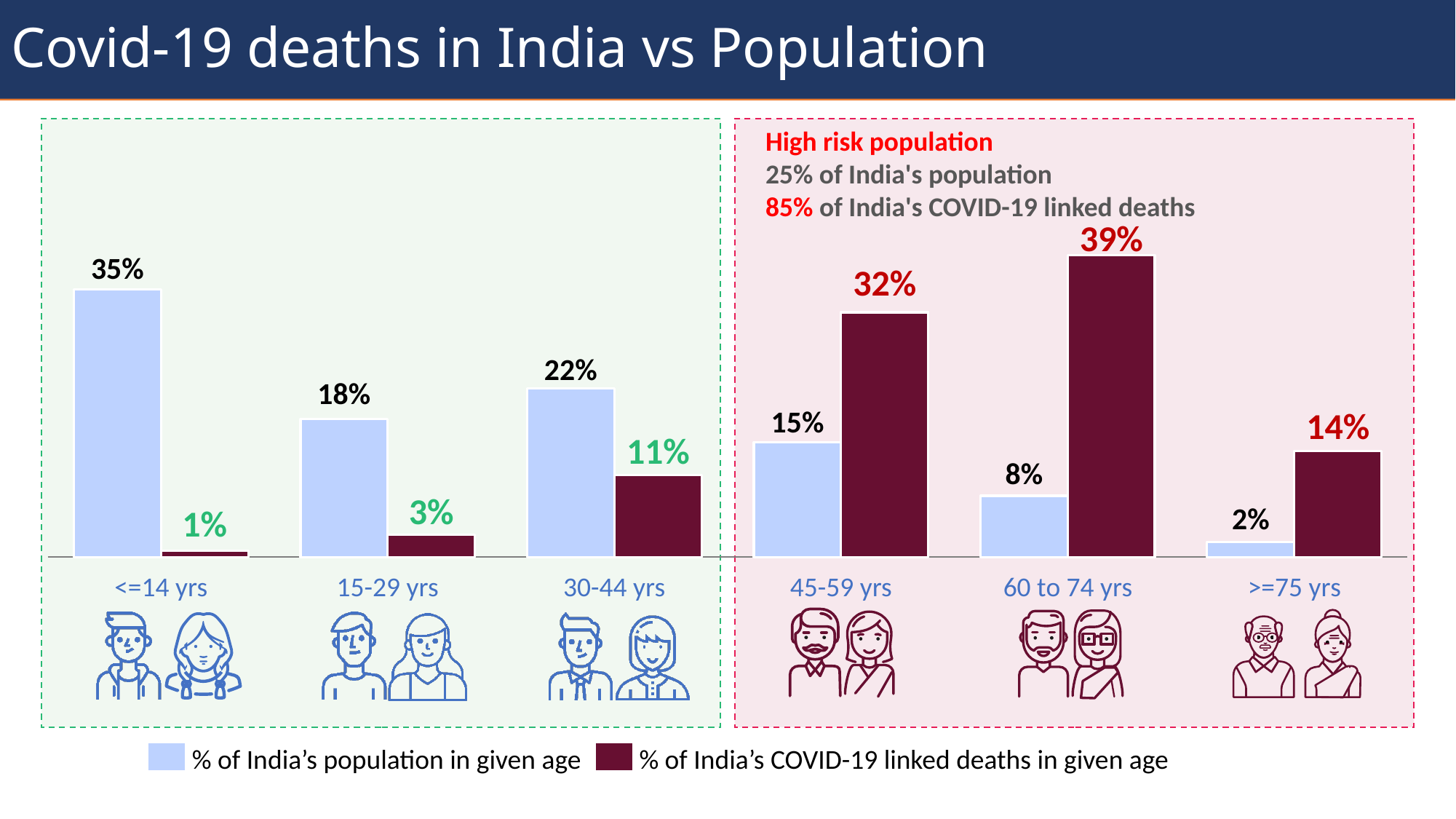
How many series does the legend list? 2 Which age group has the highest share of India's COVID-19 linked deaths? 60 to 74 yrs According to the slide, what percentage of India's COVID-19 linked deaths come from the high risk population? 85% What is the difference between the population share and the COVID-19 deaths share for the 30-44 yrs age group? 11% What percentage of India's COVID-19 linked deaths are in the 60 to 74 yrs age group? 39% What percentage of India's population is in the <=14 yrs age group? 35% What percentage of India's COVID-19 linked deaths are in the 45-59 yrs age group? 32% Do the COVID-19 linked deaths percentages rise or fall from <=14 yrs to 60 to 74 yrs? Rise How many age groups are shown on the chart? 6 Which age group has the lowest share of India's population? >=75 yrs What type of chart is shown on the slide? Bar chart For the 45-59 yrs age group, which is larger: the share of India's population or the share of COVID-19 linked deaths? % of India's COVID-19 linked deaths in given age